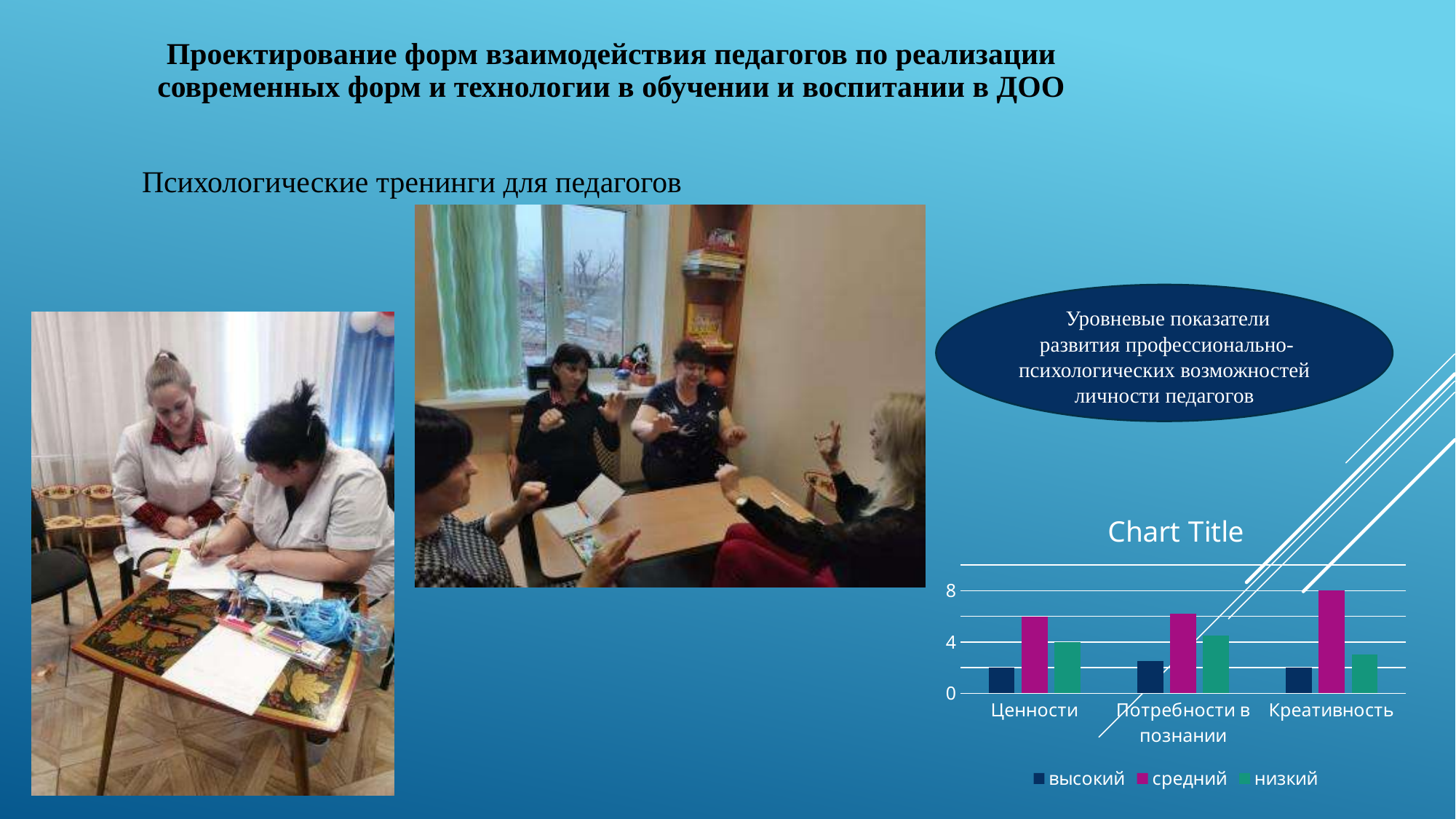
In the Ценности category, which is larger: the средний value or the низкий value? средний Which series has the lowest value in the Креативность category? высокий How many categories are shown on the x axis of the chart? 3 Is the value for высокий in Ценности greater or less than 4? less Which category has the highest value for the средний series? Креативность Which series has the highest value in the Ценности category? средний Is the value for средний in Креативность greater or less than 4? greater What kind of chart is shown on the slide? bar chart What is the title of the chart? Chart Title How many series does the chart's legend list? 3 Is the value for низкий in Креативность greater or less than 4? less What are the three series listed in the chart's legend? высокий, средний, низкий